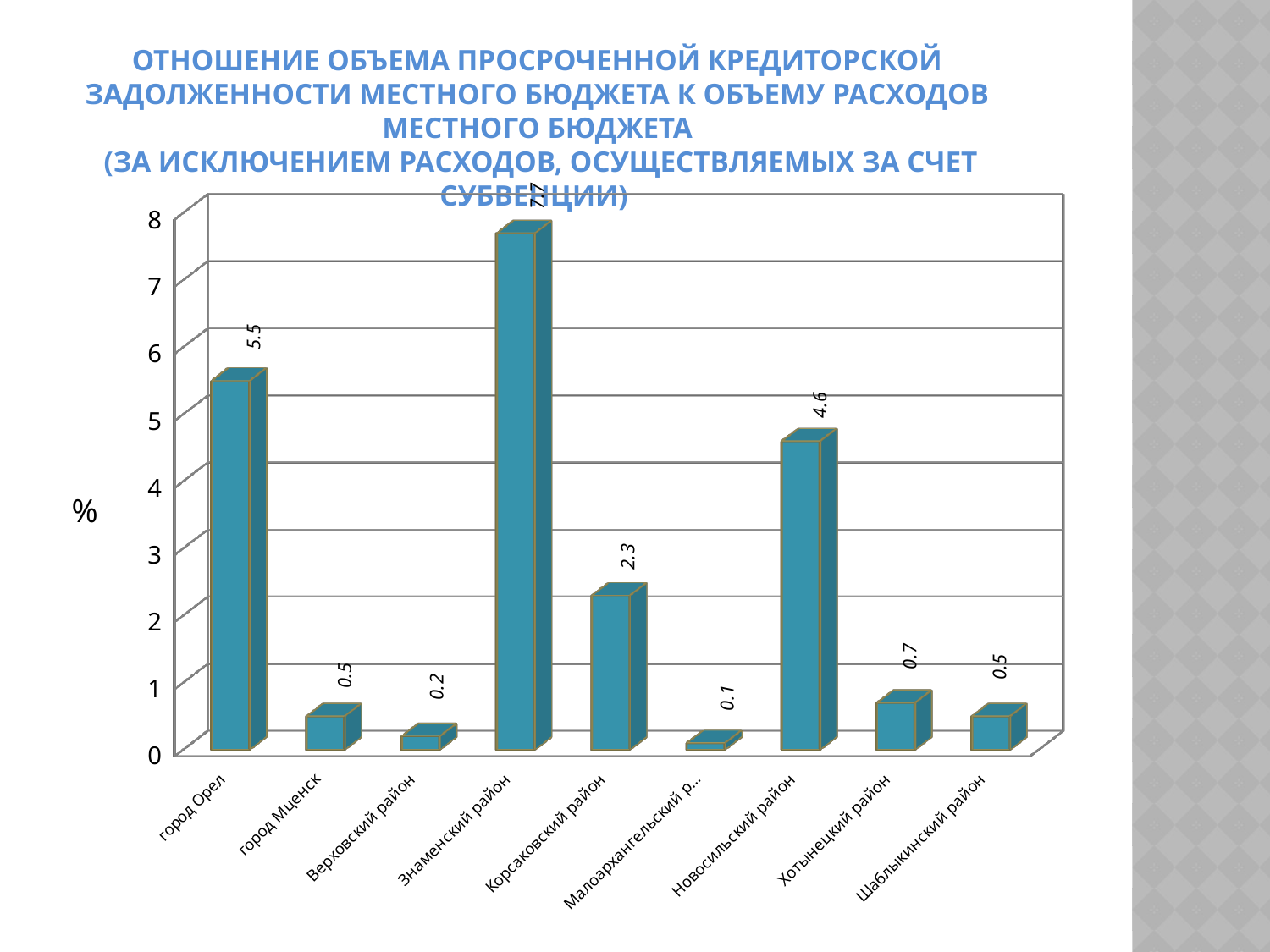
What is the difference between the values for город Орел and Новосильский район? 0.9 Which category has the highest value? Знаменский район Which is larger, the value for Хотынецкий район or Шаблыкинский район? Хотынецкий район Which category has the lowest value? Малоархангельский р... What is the value for Верховский район? 0.2 Is the value for Знаменский район greater or less than 7? greater How many categories are shown on the x axis? 9 What is the value for Новосильский район? 4.6 What is the value for Корсаковский район? 2.3 What kind of chart is shown on the slide? bar chart What unit is shown on the vertical axis label? % What is the value for город Орел? 5.5